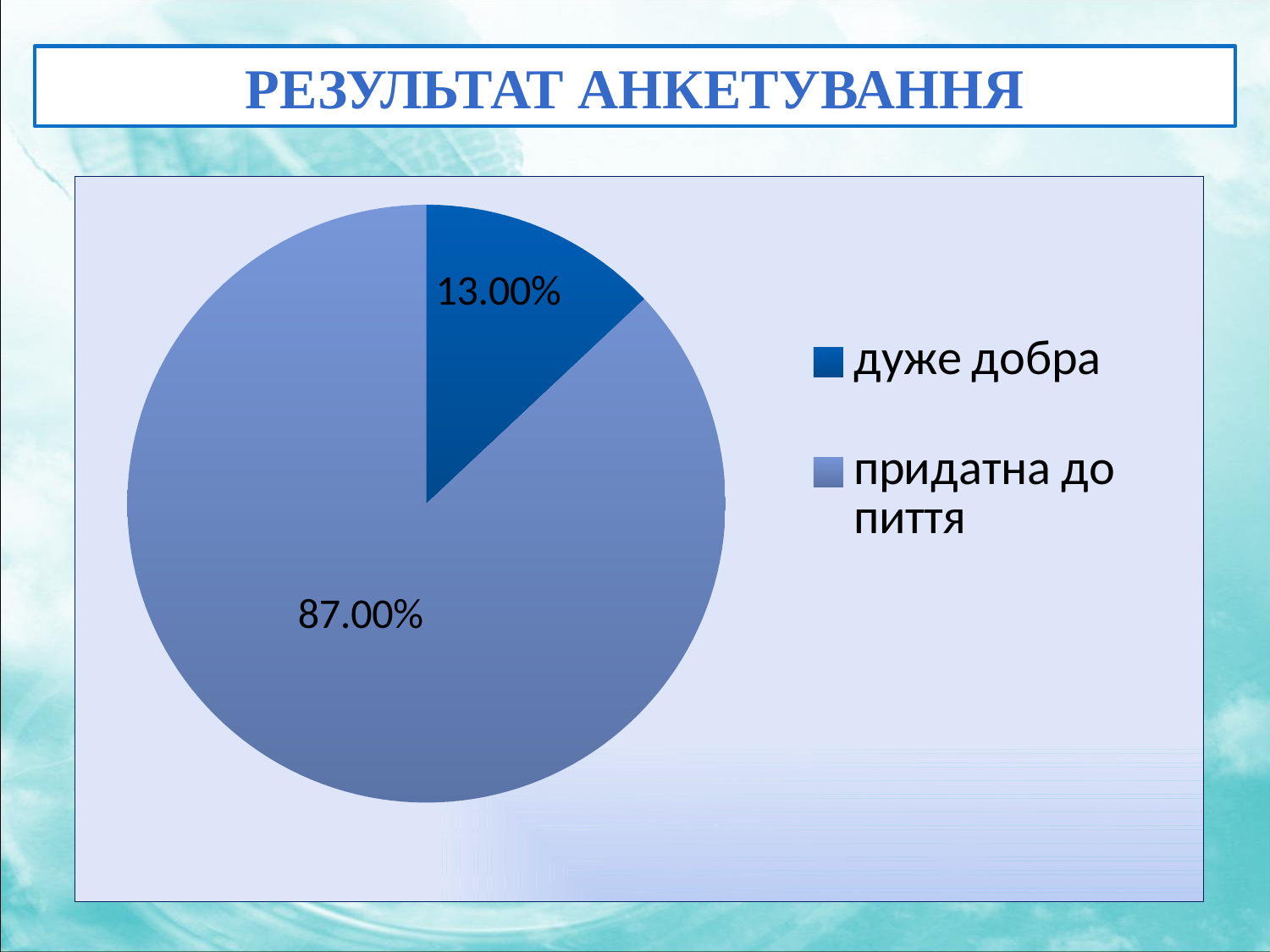
What share of the pie does "дуже добра" take? 13.00% How many entries does the legend list? 2 What is the title shown above the chart on the slide? РЕЗУЛЬТАТ АНКЕТУВАННЯ What share of the pie does "придатна до пиття" take? 87.00% Which category has the largest slice of the pie? придатна до пиття What kind of chart is shown on the slide? pie chart What is the difference between the shares of "придатна до пиття" and "дуже добра"? 74.00% Which category has the smallest slice of the pie? дуже добра Which is larger: the slice for "дуже добра" or the slice for "придатна до пиття"? придатна до пиття Which legend entry is shown in the darker blue colour? дуже добра How many slices does the pie chart have? 2